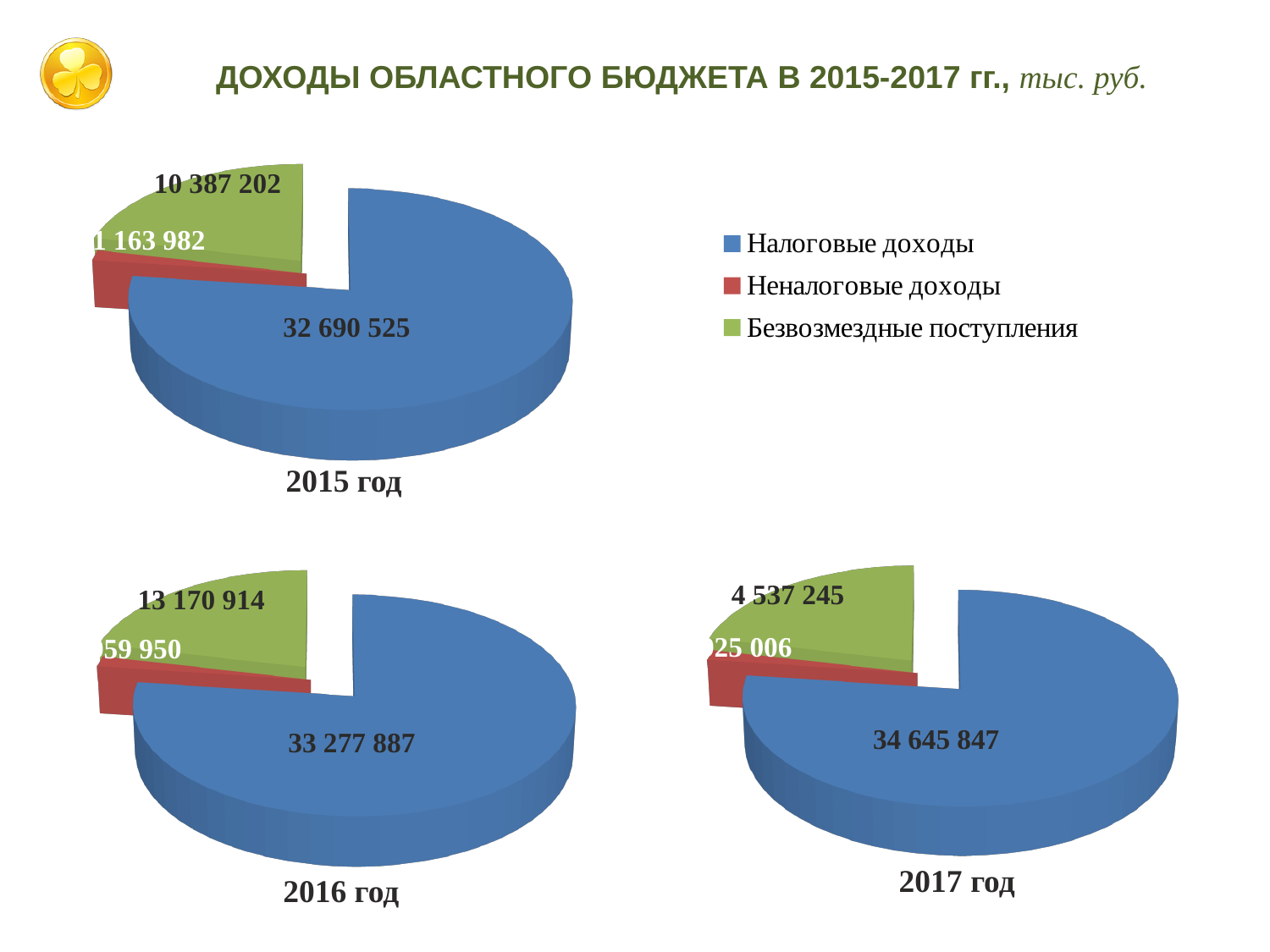
Is the value for Безвозмездные поступления larger in the 2016 год chart or the 2017 год chart? 2016 год Which colour represents Неналоговые доходы in the legend? Red What type of chart is used for the 2015 год data? Pie chart On the 2015 год pie chart, what is the value for Налоговые доходы? 32 690 525 On the 2016 год pie chart, which category has the smallest slice? Неналоговые доходы On the 2017 год pie chart, which category has the largest slice? Налоговые доходы On the 2017 год pie chart, what is the value for Безвозмездные поступления? 4 537 245 On the 2016 год pie chart, what is the value for Безвозмездные поступления? 13 170 914 On the 2016 год pie chart, what is the value for Налоговые доходы? 33 277 887 How many categories does the legend list for the pie charts? 3 On the 2017 год pie chart, what is the value for Налоговые доходы? 34 645 847 On the 2015 год pie chart, what is the value for Безвозмездные поступления? 10 387 202